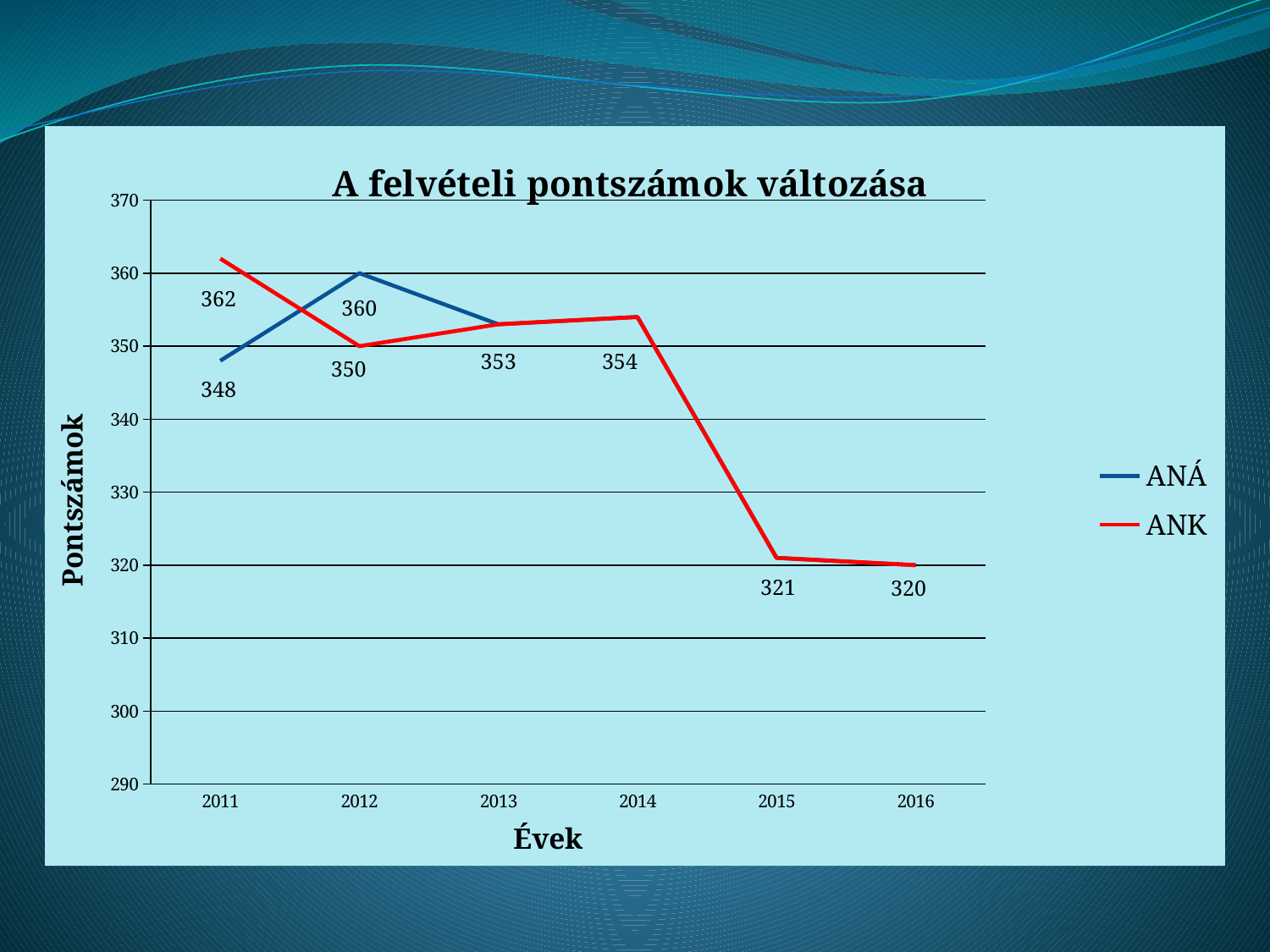
How many years are shown on the x axis? 6 In which year is the ANK value highest? 2011 What is the ANK value for 2016? 320 What is the ANÁ value for 2011? 348 What is the difference between the ANK values for 2011 and 2012? 12 What kind of chart is shown on the slide? line chart What is the ANK value for 2011? 362 How many series does the legend list? 2 What is the ANÁ value for 2012? 360 What is the ANK value for 2015? 321 In 2012, which series has the larger value, ANÁ or ANK? ANÁ In which year is the ANK value lowest? 2016